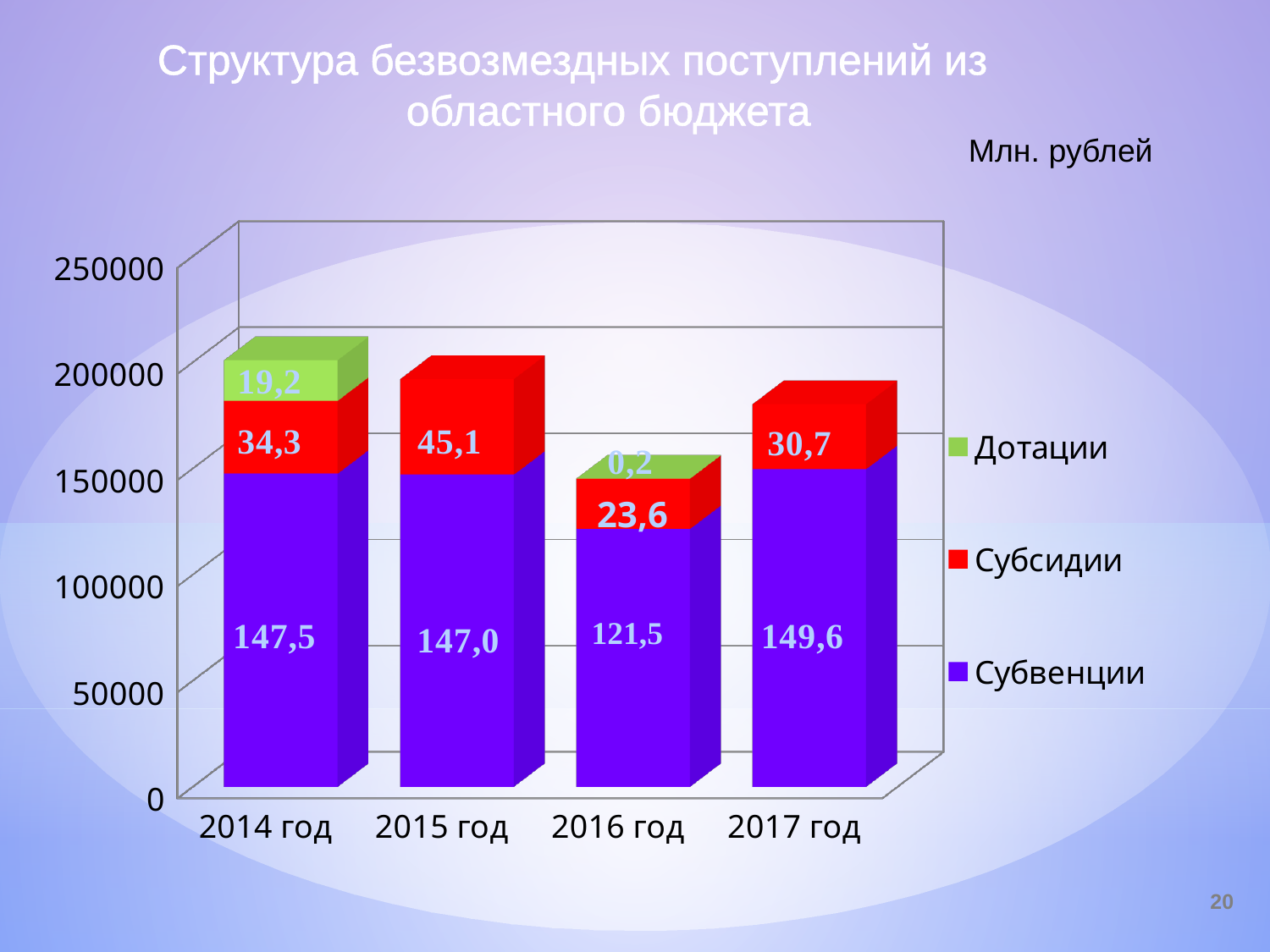
In which year is the Субвенции value the lowest? 2016 год Which legend entry is shown in red? Субсидии How many series does the legend list? 3 What type of chart is shown on the slide? Stacked bar chart What is the value of Субсидии for 2015 год? 45,1 What is the value of Субвенции for 2014 год? 147,5 What is the value of Дотации for 2016 год? 0,2 Which is larger: Субсидии in 2014 год or Субсидии in 2017 год? 2014 год (34,3) What is the difference between the Субсидии values for 2015 год and 2016 год? 21,5 What is the total of the stacked bar for 2014 год? 201,0 How many years (categories) are shown on the x axis? 4 In which year is the Субвенции value the highest? 2017 год